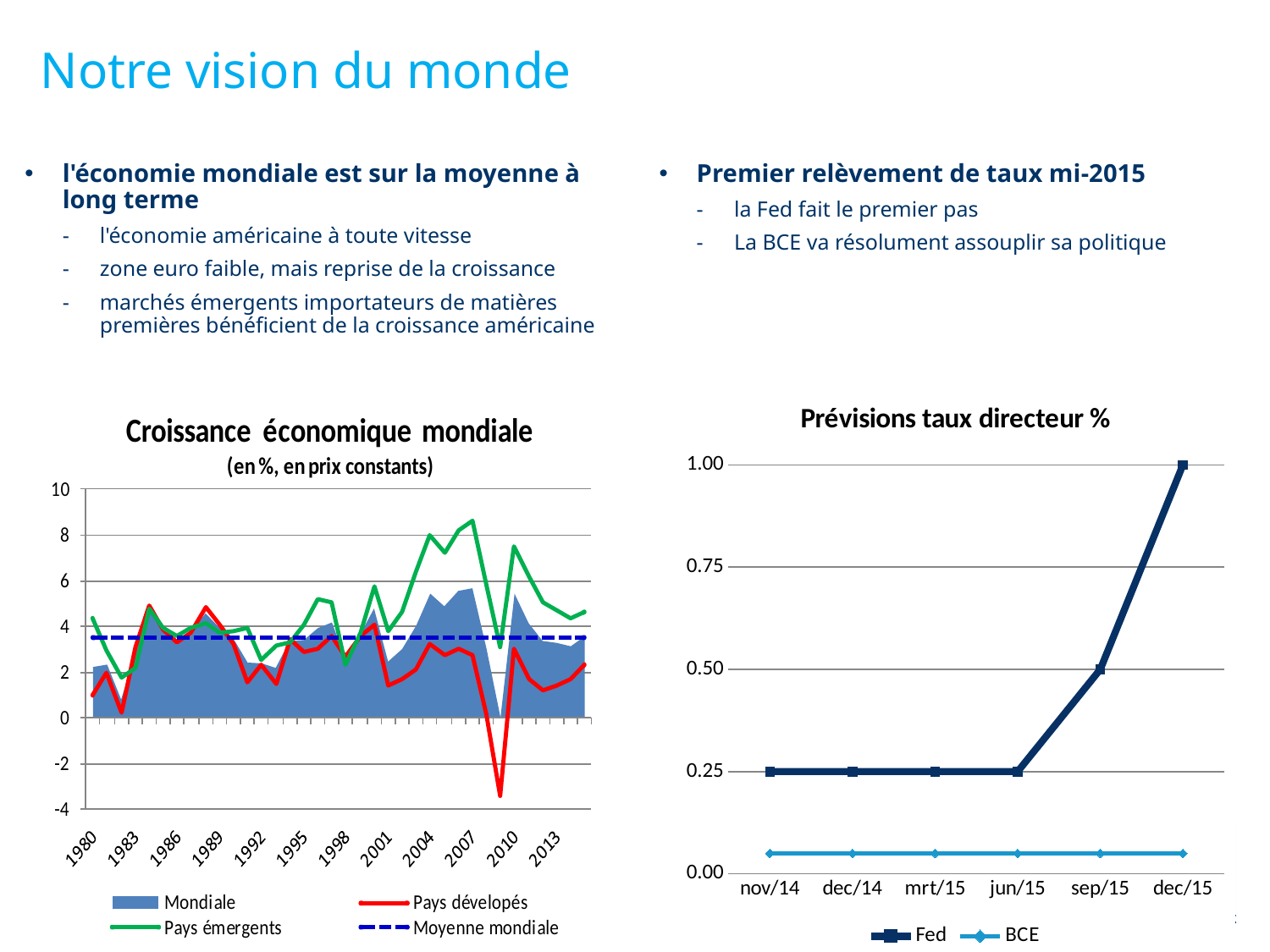
In the chart titled 'Prévisions taux directeur %', is the BCE value for dec/15 greater or less than 0.25? less In the chart titled 'Croissance économique mondiale', which series is shown as a dashed blue line? Moyenne mondiale In the chart titled 'Croissance économique mondiale', is the value for Pays développés in 2009 greater or less than -2? less In the chart titled 'Prévisions taux directeur %', what is the Fed value for sep/15? 0.50 In the chart titled 'Prévisions taux directeur %', what is the difference between the Fed value for dec/15 and the Fed value for jun/15? 0.75 In the chart titled 'Prévisions taux directeur %', what is the Fed value for dec/15? 1.00 In the chart titled 'Prévisions taux directeur %', does the Fed series rise or fall from jun/15 to dec/15? rise In the chart titled 'Prévisions taux directeur %', which series is higher at dec/15, Fed or BCE? Fed In the chart titled 'Prévisions taux directeur %', how many series does the legend list? 2 In the chart titled 'Prévisions taux directeur %', what is the Fed value for nov/14? 0.25 In the chart titled 'Prévisions taux directeur %', how many dates are shown on the x axis? 6 In the chart titled 'Croissance économique mondiale', how many series does the legend list? 4